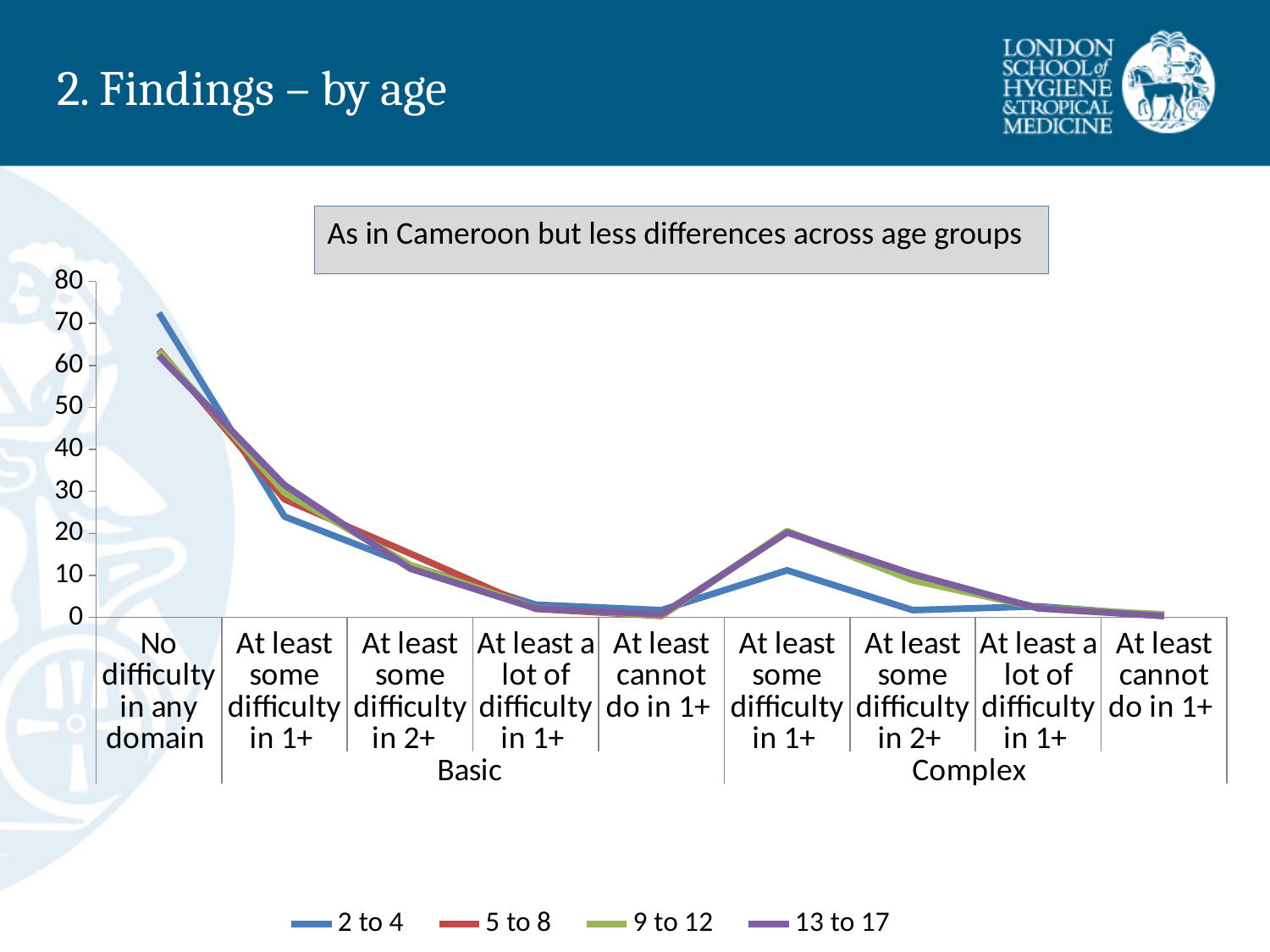
Is the value for the 2 to 4 age group at 'No difficulty in any domain' greater or less than 60? greater Across the Basic categories from 'At least some difficulty in 1+' to 'At least cannot do in 1+', do the values rise or fall? fall What kind of chart is shown on the slide? line chart Is the value for the 2 to 4 age group at 'At least some difficulty in 1+' in the Complex group greater or less than 20? less How many series does the legend list? 4 Is the value for the 13 to 17 age group at 'No difficulty in any domain' greater or less than 70? less Which age group has the lowest value for 'At least some difficulty in 1+' in the Complex group? 2 to 4 Which age group has the highest value for 'No difficulty in any domain'? 2 to 4 At 'At least some difficulty in 1+' in the Complex group, which is larger: the value for 13 to 17 or for 2 to 4? 13 to 17 What does the text box above the chart say? As in Cameroon but less differences across age groups How many categories are shown along the x axis? 9